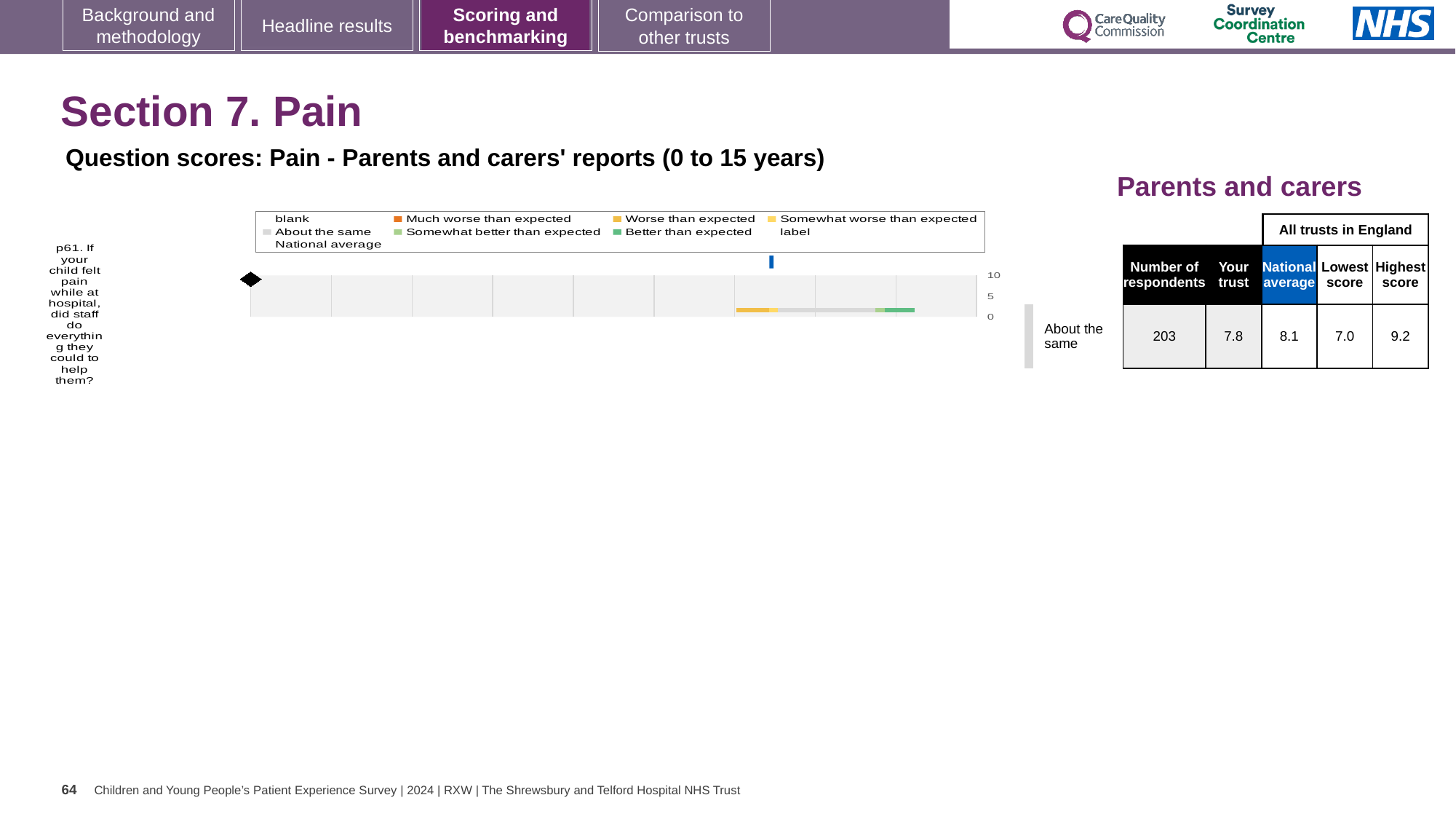
What is the highest score among all trusts in England for question p61? 9.2 Is the 'Your trust' score for question p61 greater or less than 5? greater How many survey questions are plotted in the chart? 1 What is the difference between the national average and the 'Your trust' score for question p61? 0.3 How many respondents answered question p61? 203 Which benchmarking category is the trust's result for question p61 placed in? About the same What is the 'Your trust' score for question p61? 7.8 Which is higher for question p61, the 'Your trust' score or the national average? National average What is the lowest score among all trusts in England for question p61? 7.0 What kind of chart is shown on the slide? bar chart What is the national average score for question p61? 8.1 What is the difference between the highest and lowest scores among all trusts in England for question p61? 2.2